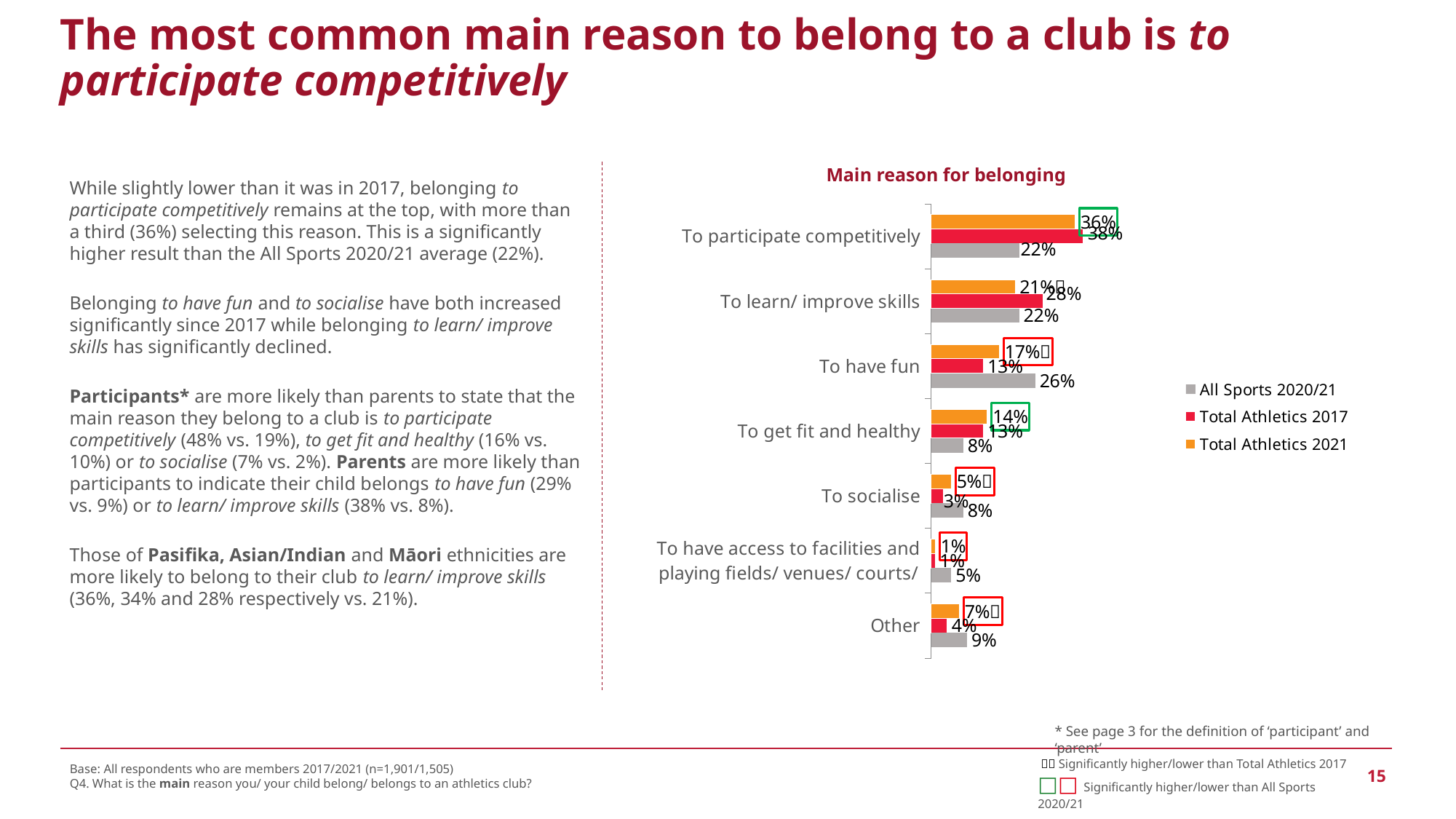
What kind of chart is shown on the slide? Bar chart What is the Total Athletics 2017 value for 'To learn/ improve skills'? 28% How many series does the chart legend list? 3 How many reason categories are plotted in the chart? 7 What is the difference between the Total Athletics 2017 and Total Athletics 2021 values for 'To learn/ improve skills'? 7% What is the Total Athletics 2021 value for 'Other'? 7% What is the title of the chart? Main reason for belonging For 'To have fun', which is larger: the All Sports 2020/21 value or the Total Athletics 2021 value? All Sports 2020/21 Which category has the lowest All Sports 2020/21 value? To have access to facilities and playing fields/ venues/ courts/ What is the All Sports 2020/21 value for 'To have fun'? 26% Which category has the highest Total Athletics 2021 value? To participate competitively What is the Total Athletics 2021 value for 'To participate competitively'? 36%